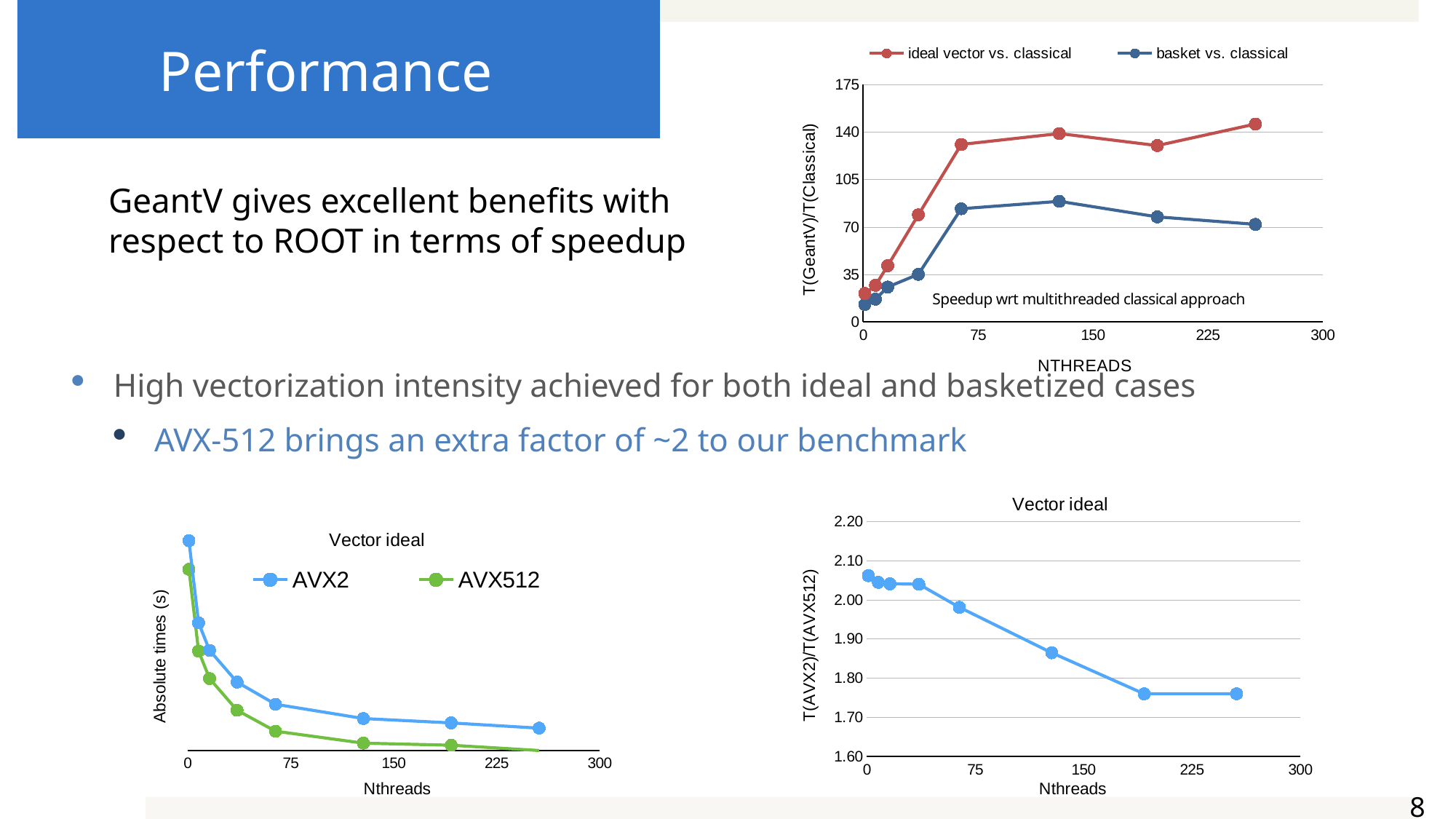
In the bottom-left 'Vector ideal' chart, which series has the higher absolute time at 0 threads, AVX2 or AVX512? AVX2 In the top-right chart, how many series does the legend list? 2 In the top-right chart, is the value of 'basket vs. classical' at about 128 threads greater or less than 105? less What is the x-axis label of the top-right chart? NTHREADS In the bottom-right 'Vector ideal' chart, is the value of T(AVX2)/T(AVX512) at 0 threads greater or less than 2.00? greater In the bottom-right 'Vector ideal' chart, is the value of T(AVX2)/T(AVX512) at the highest thread count (about 256) greater or less than 1.80? less In the bottom-left 'Vector ideal' chart, do the absolute times rise or fall as Nthreads increases? fall What kind of chart is the bottom-right 'Vector ideal' chart? line chart In the top-right chart, what are the two series named in the legend? ideal vector vs. classical; basket vs. classical In the top-right chart, which series reaches higher values at 256 threads, 'ideal vector vs. classical' or 'basket vs. classical'? ideal vector vs. classical